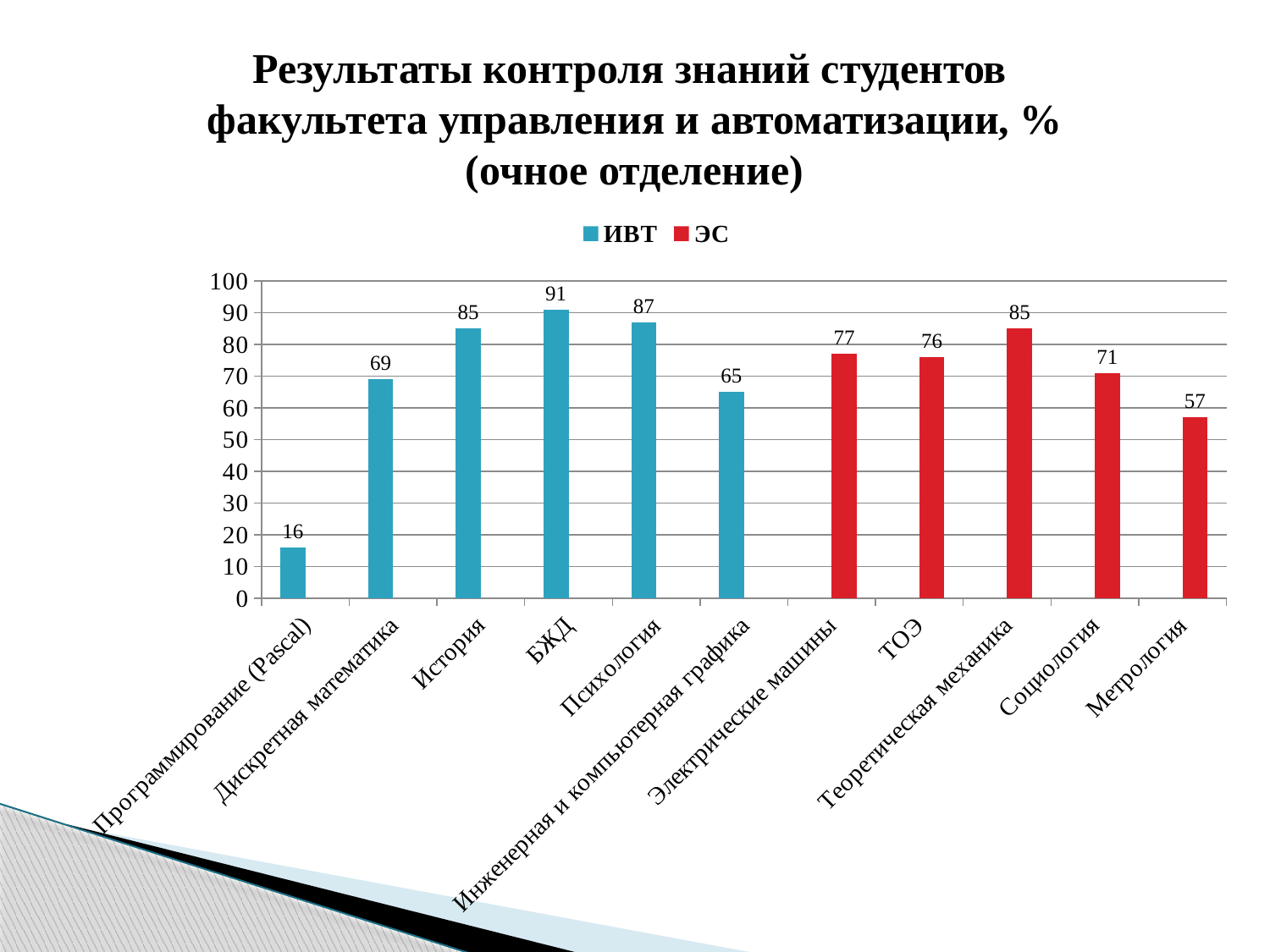
How many series does the legend list? 2 Which category has the lowest value? Программирование (Pascal) How many categories are shown on the x axis? 11 What is the difference between the values for Психология and Социология? 16 Which category has the highest value? БЖД Which series is shown in red? ЭС What is the value for Программирование (Pascal)? 16 What is the value for Теоретическая механика? 85 Which is larger, the value for Электрические машины or the value for Инженерная и компьютерная графика? Электрические машины What kind of chart is shown on the slide? bar chart What is the value for БЖД? 91 What is the value for Метрология? 57